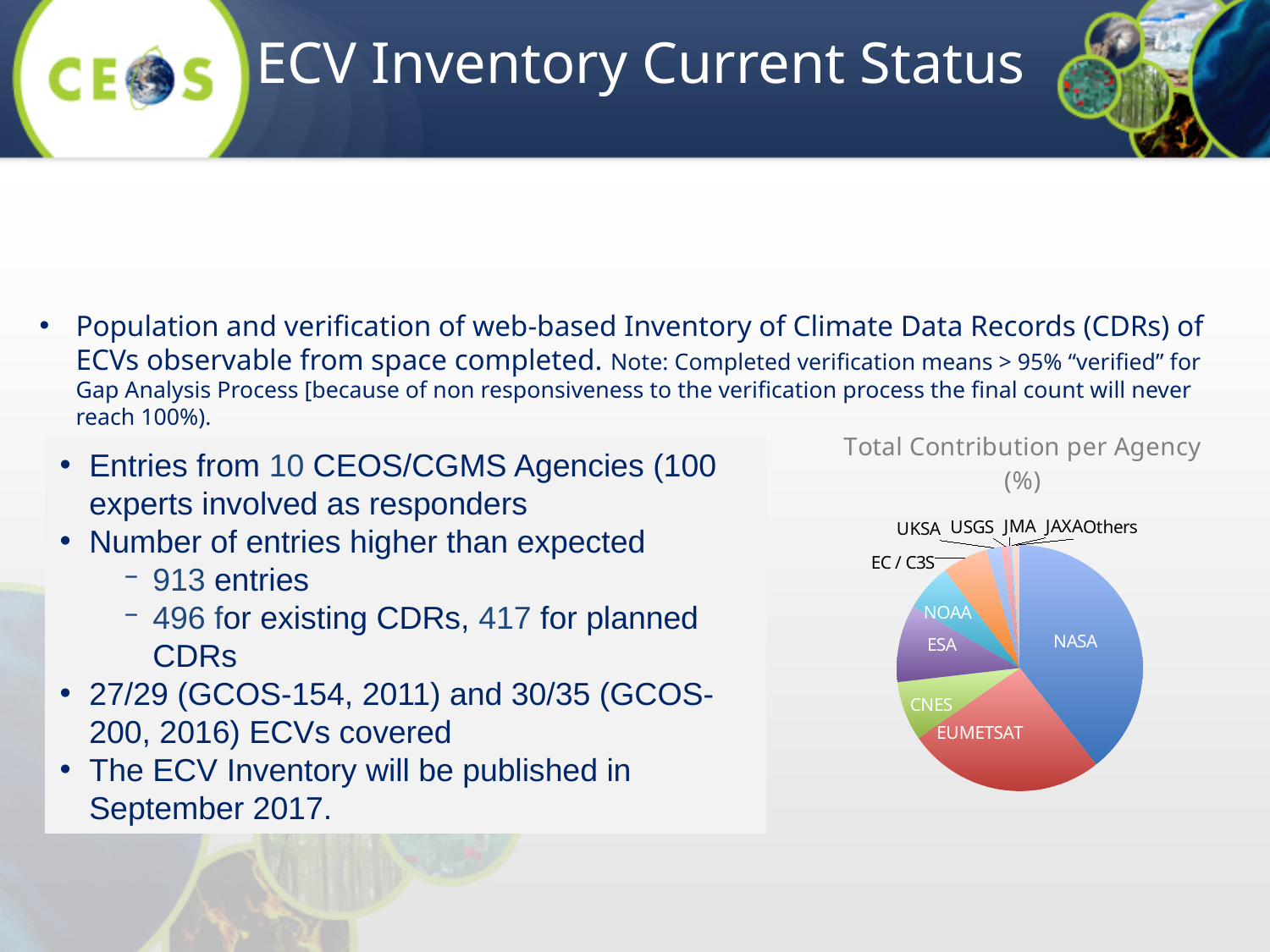
Which agency has the second-largest slice in the pie chart? EUMETSAT Which slice is larger in the pie chart, NASA or ESA? NASA What kind of chart is shown on the slide? pie chart Which slice is larger in the pie chart, ESA or NOAA? ESA What is the title of the chart on the slide? Total Contribution per Agency (%) What colour is the NASA slice in the pie chart? blue Which agency has the largest slice in the pie chart? NASA Which slice is larger in the pie chart, NASA or EUMETSAT? NASA How many agency slices are labelled in the pie chart? 11